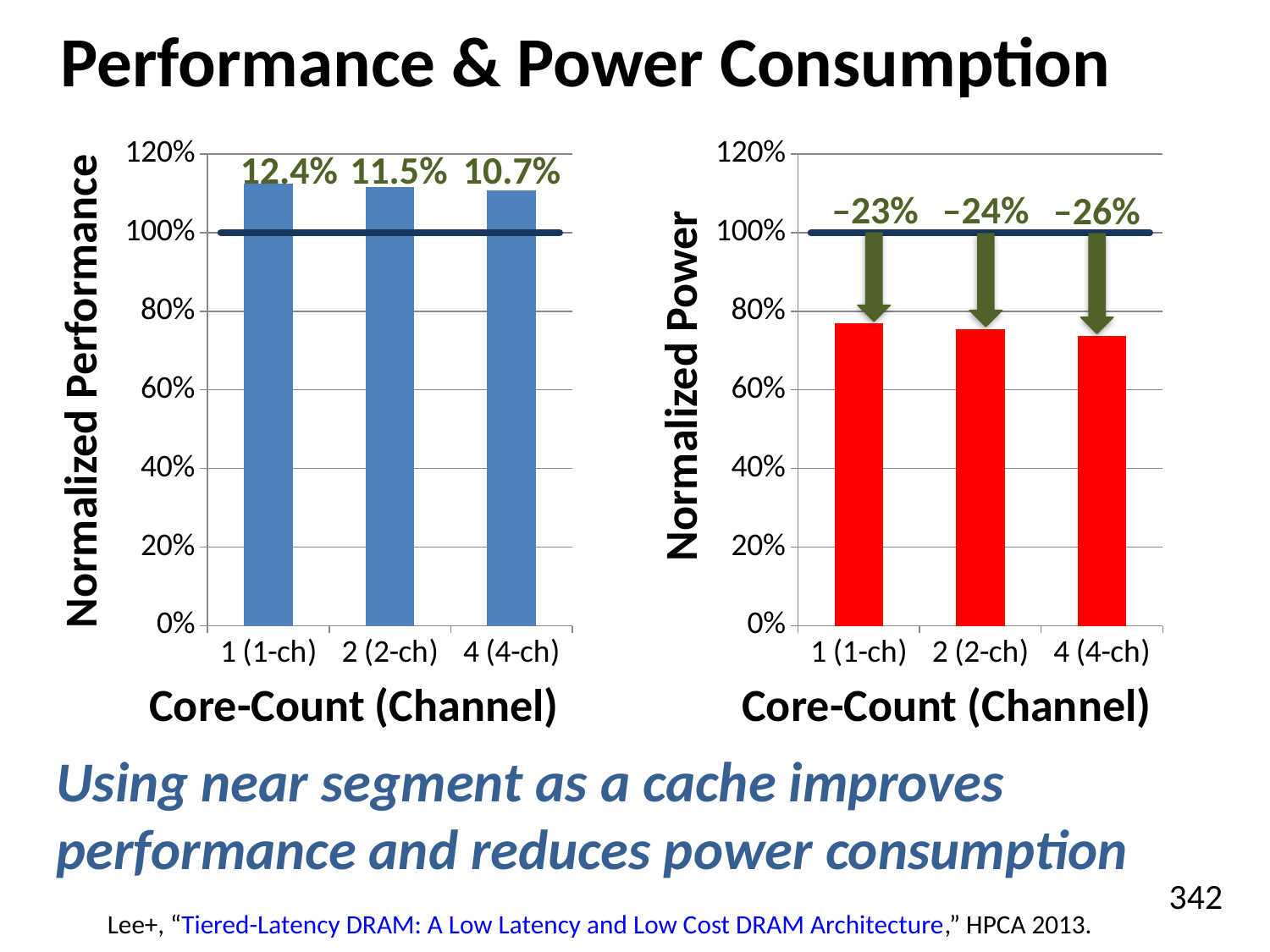
On the Normalized Performance chart (left), what improvement label is printed above the 1 (1-ch) bar? 12.4% On the Normalized Power chart (right), is the value for 1 (1-ch) greater or less than 80%? less On the Normalized Performance chart (left), which core-count category shows the largest performance improvement label? 1 (1-ch) On the Normalized Power chart (right), is the value for 4 (4-ch) greater or less than 60%? greater On the Normalized Power chart (right), which core-count category shows the largest power reduction label? 4 (4-ch) What is the x-axis title of the Normalized Power chart (right)? Core-Count (Channel) On the Normalized Power chart (right), what reduction label is printed above the 4 (4-ch) bar? –26% On the Normalized Performance chart (left), is the value for 2 (2-ch) greater or less than 100%? greater On the Normalized Power chart (right), what reduction label is printed above the 2 (2-ch) bar? –24% How many core-count categories are shown on the Normalized Power chart (right)? 3 On the Normalized Performance chart (left), what improvement label is printed above the 4 (4-ch) bar? 10.7% What kind of chart is the Normalized Performance chart (left)? Bar chart